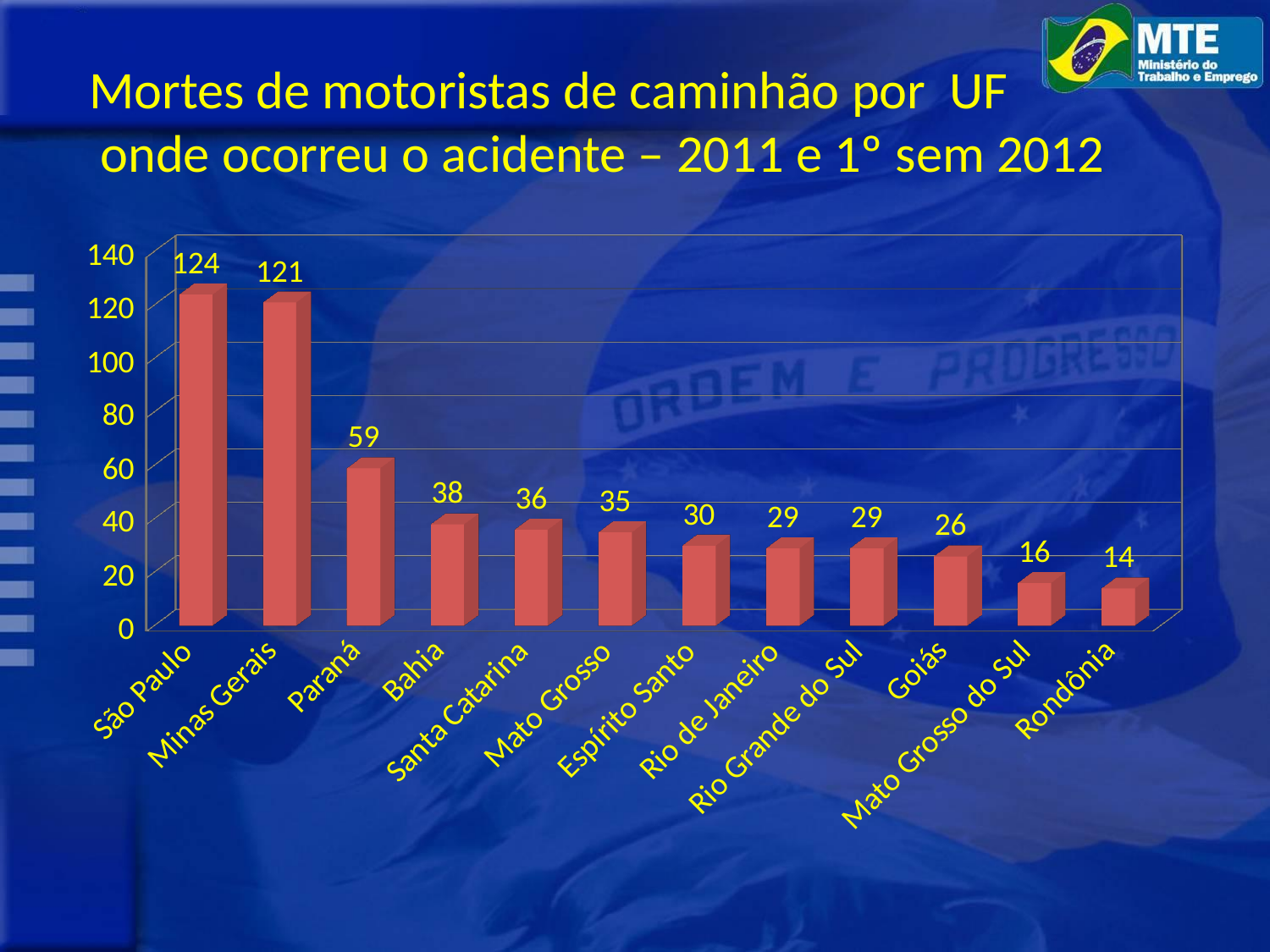
What kind of chart is shown on the slide? Bar chart Which state has the lowest value? Rondônia What is the value for Goiás? 26 What is the value for Rondônia? 14 Do the values rise or fall from left to right along the x axis? Fall What is the difference between the values for Paraná and Bahia? 21 Which state has the highest value? São Paulo What is the difference between the values for São Paulo and Minas Gerais? 3 What is the value for São Paulo? 124 Which is larger, the value for Santa Catarina or the value for Mato Grosso do Sul? Santa Catarina What is the value for Paraná? 59 How many states are shown on the x axis? 12